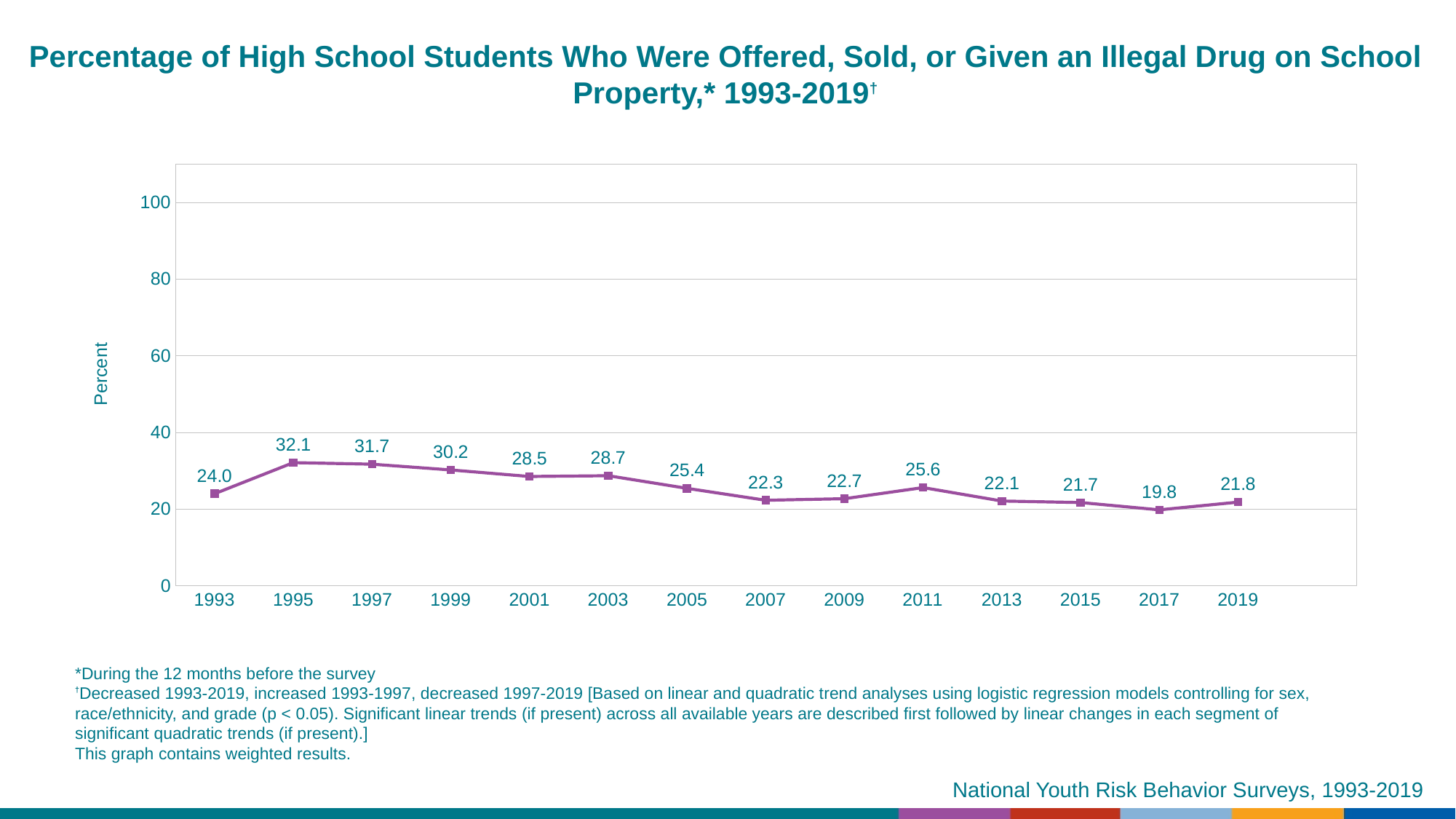
What is the difference between the values for 1995 and 2019? 10.3 What kind of chart is shown on the slide? line chart Overall, do the values rise or fall from 1997 to 2019? fall What is the label on the y axis? Percent What value is shown for 2011? 25.6 How many years are plotted on the chart? 14 Which year has the highest percentage? 1995 Which year has the lowest percentage? 2017 What value is shown for 2017? 19.8 Which is larger, the value for 2003 or the value for 2001? 2003 What was the percentage of high school students who were offered, sold, or given an illegal drug on school property in 1993? 24.0 Is the value for 1997 greater or less than 40? less